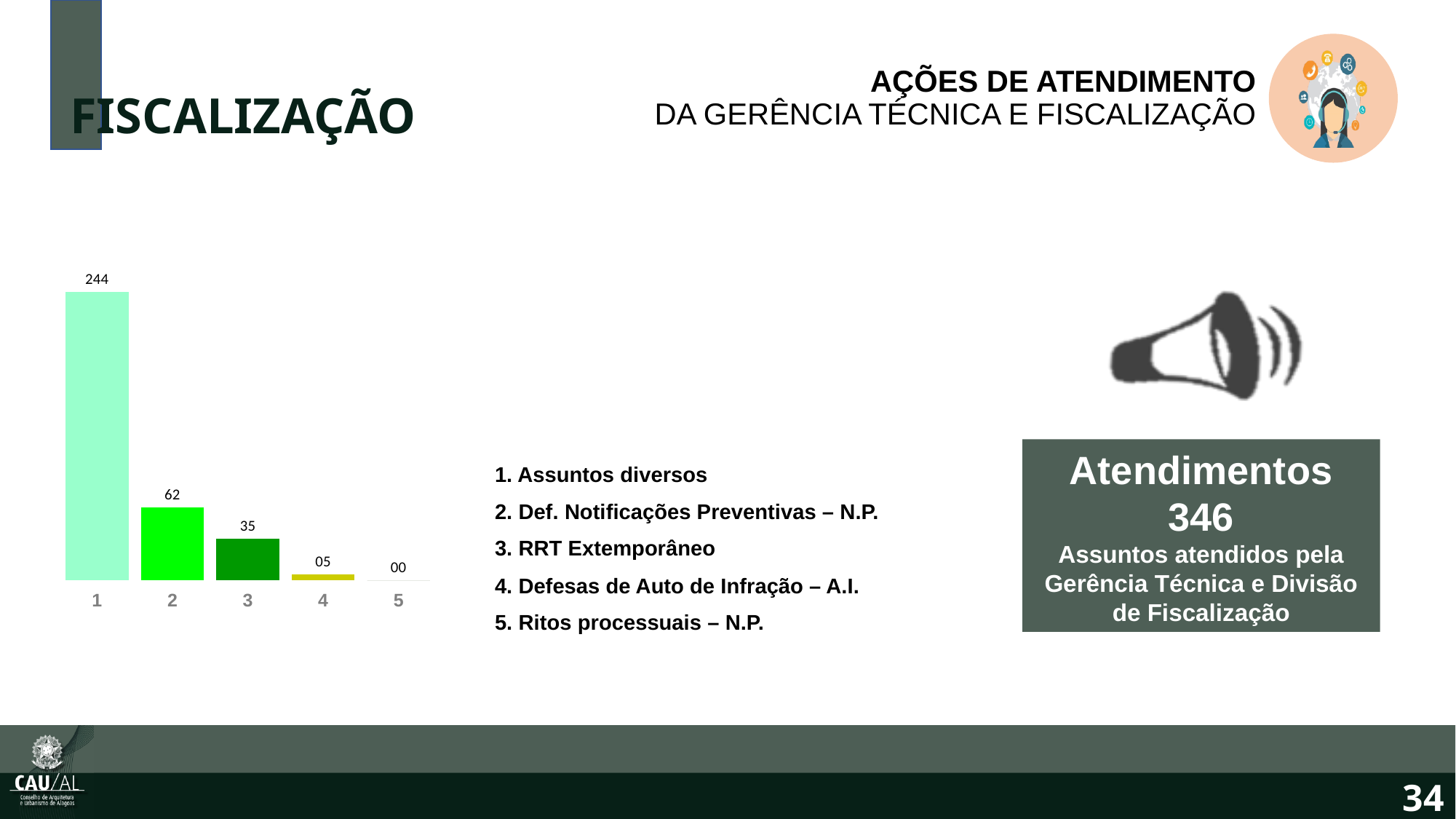
What is the difference between the values for category 1 and category 2? 182 What is the value shown for category 5 in the bar chart? 00 Which is larger, the value for category 2 or the value for category 3? Category 2 Which category has the highest value in the bar chart? 1 Do the values rise or fall from category 1 to category 5? Fall What is the value shown for category 3 in the bar chart? 35 What is the value shown for category 1 in the bar chart? 244 What kind of chart is shown on the slide? Bar chart What is the value shown for category 2 in the bar chart? 62 What is the value shown for category 4 in the bar chart? 05 How many categories are shown in the bar chart? 5 Which category has the lowest value in the bar chart? 5